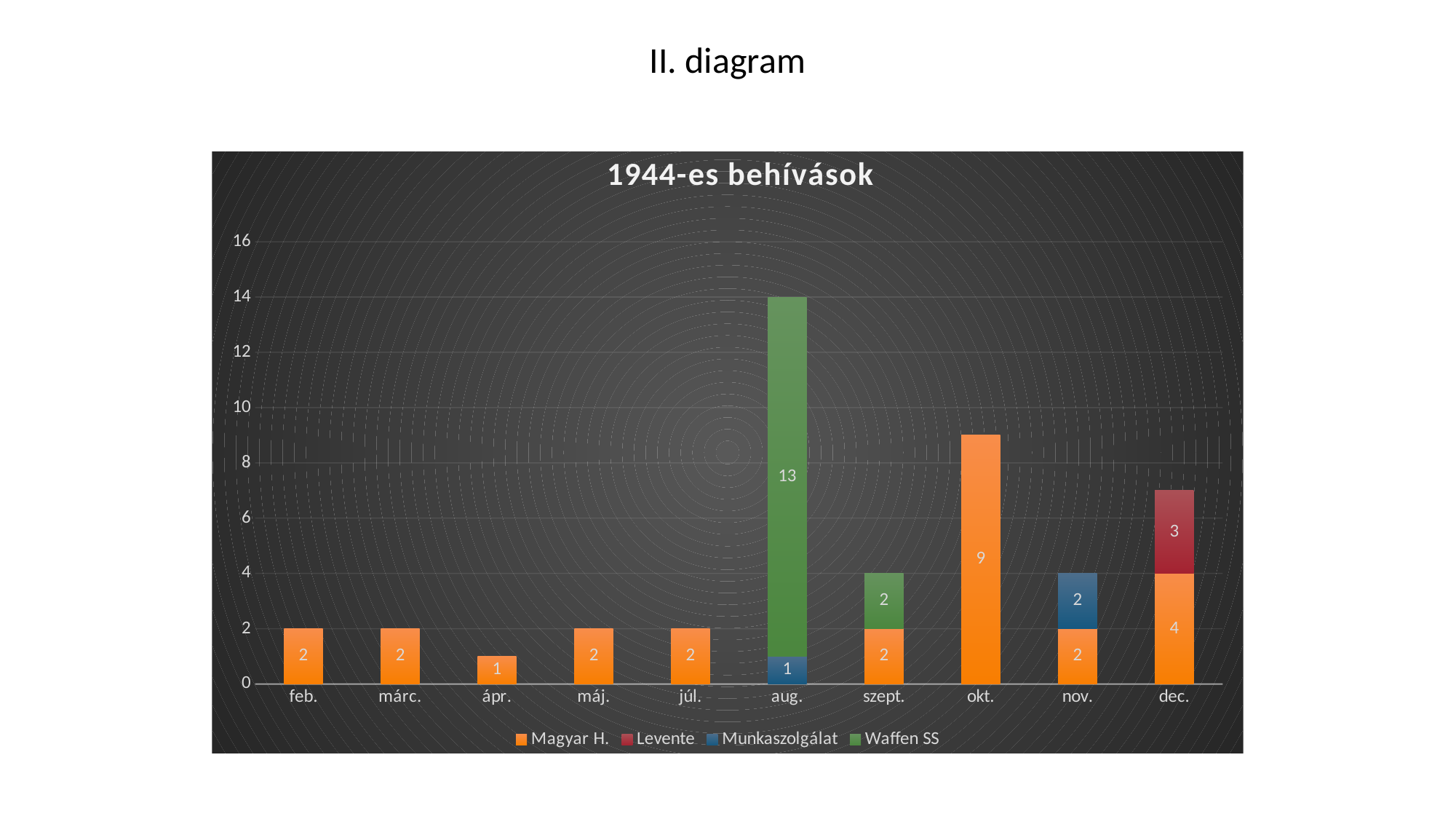
What is the total of the stacked bar for dec.? 7 What is the Waffen SS value for aug.? 13 What is the Magyar H. value for okt.? 9 Which month has the highest total? aug. What is the Levente value for dec.? 3 How many months are shown on the x axis? 10 How many series does the legend list? 4 What is the total of the stacked bar for aug.? 14 What is the Munkaszolgálat value for nov.? 2 What is the difference between the Magyar H. value for okt. and the Magyar H. value for dec.? 5 What is the title of the chart? 1944-es behívások What kind of chart is shown on the slide? stacked bar chart